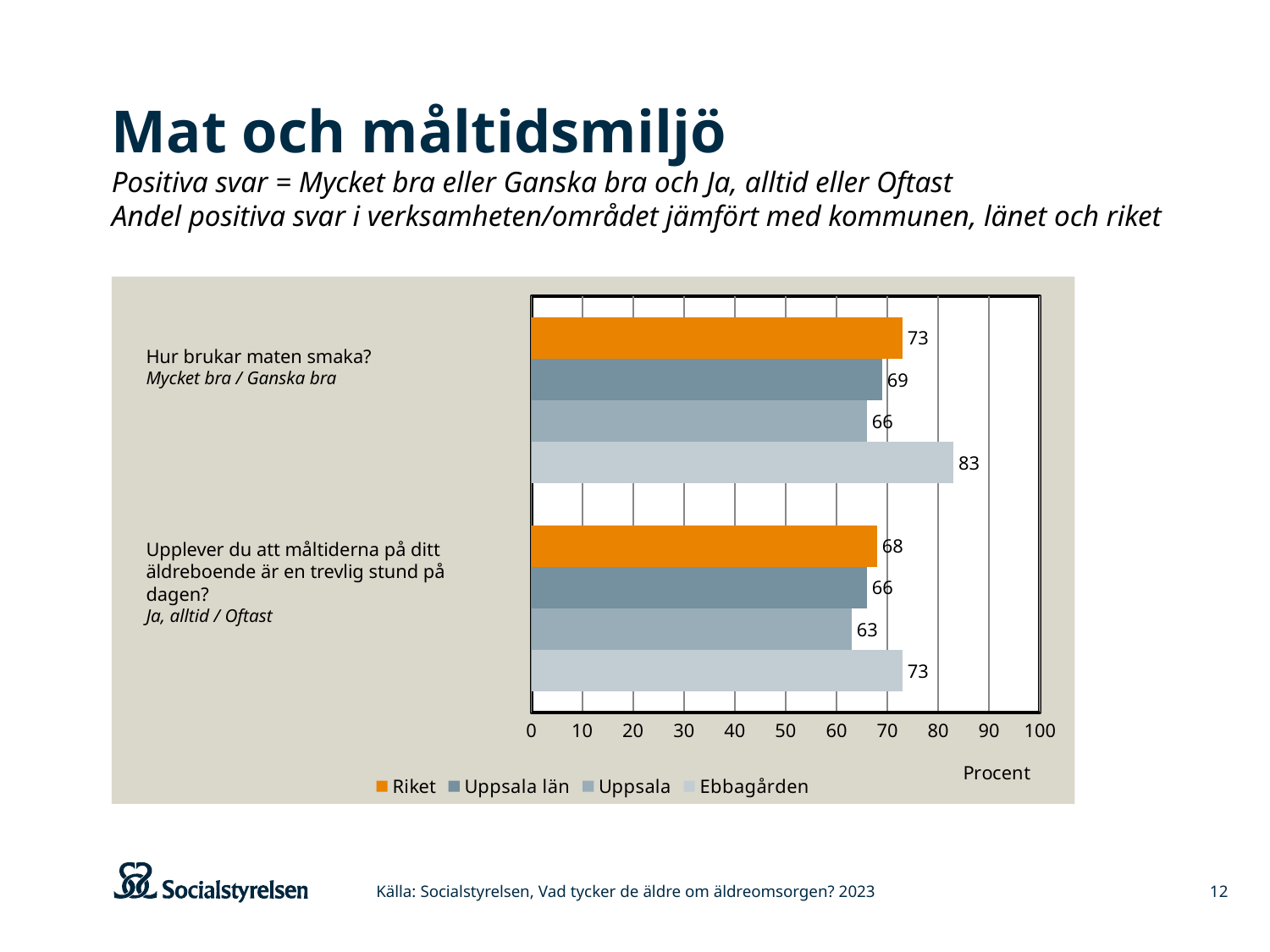
Which is larger: Riket or Uppsala län on the question "Hur brukar maten smaka?"? Riket How many series does the legend list? 4 Which series has the lowest value on the question "Upplever du att måltiderna på ditt äldreboende är en trevlig stund på dagen?"? Uppsala What is the value for Uppsala län on the question "Upplever du att måltiderna på ditt äldreboende är en trevlig stund på dagen?"? 66 What kind of chart is shown on the slide? Bar chart What is the difference between Ebbagården and Uppsala on the question "Upplever du att måltiderna på ditt äldreboende är en trevlig stund på dagen?"? 10 What is the value for Riket on the question "Hur brukar maten smaka?"? 73 What is the difference between Ebbagården and Riket on the question "Hur brukar maten smaka?"? 10 What is the value for Uppsala on the question "Upplever du att måltiderna på ditt äldreboende är en trevlig stund på dagen?"? 63 What is the label on the horizontal axis of the chart? Procent Which series has the highest value on the question "Hur brukar maten smaka?"? Ebbagården What is the value for Ebbagården on the question "Hur brukar maten smaka?"? 83